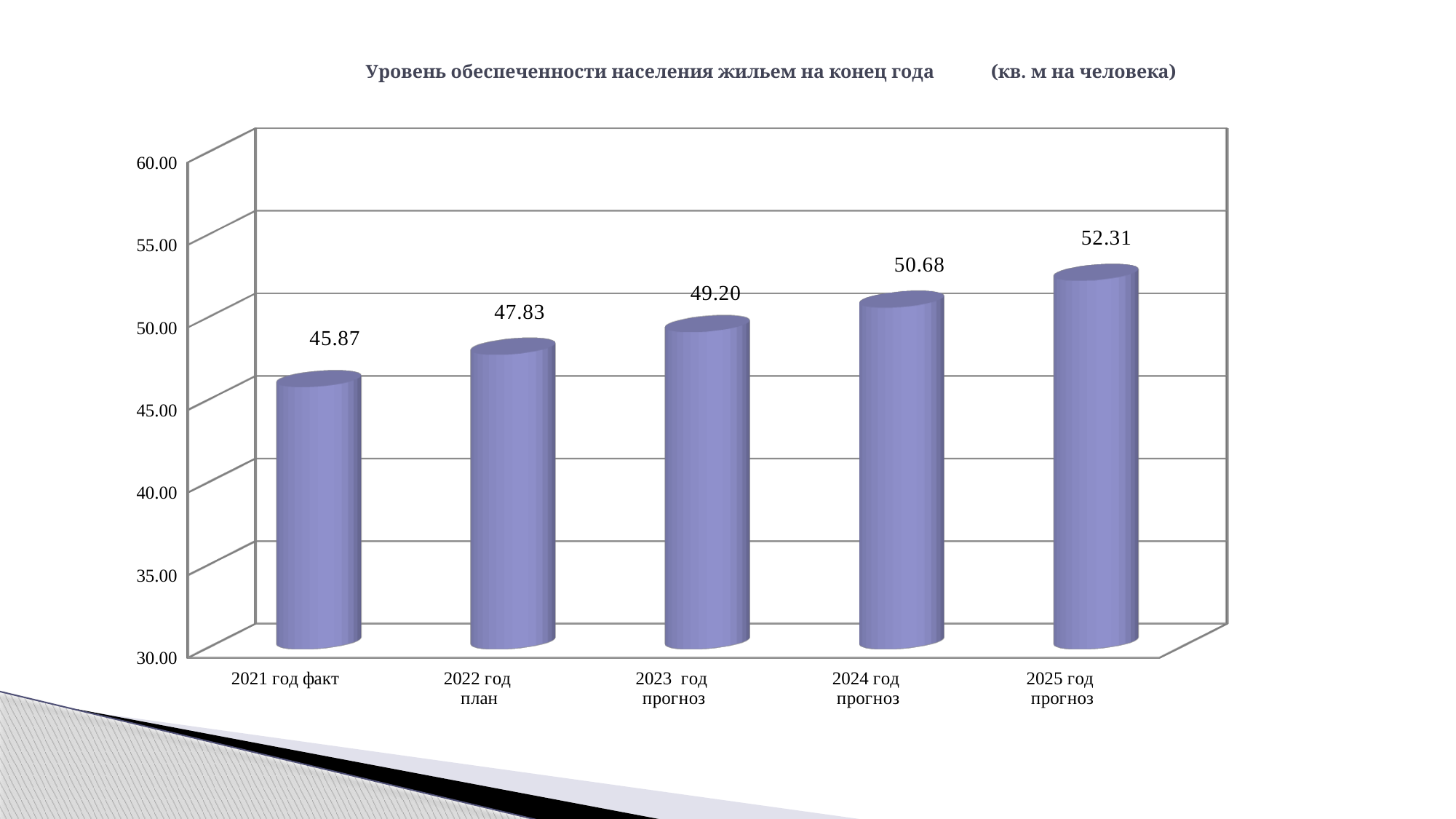
What is the difference between the values for 2024 год прогноз and 2022 год план? 2.85 Do the values rise or fall from 2021 to 2025 along the x axis? rise Which is larger, the value for 2022 год план or the value for 2024 год прогноз? 2024 год прогноз How many categories are shown on the x axis? 5 What is the value for 2021 год факт? 45.87 Is the value for 2023 год прогноз greater or less than 50.00? less What is the value for 2023 год прогноз? 49.20 What kind of chart is shown on the slide? bar chart What is the difference between the values for 2025 год прогноз and 2021 год факт? 6.44 Which category has the lowest value? 2021 год факт Which category has the highest value? 2025 год прогноз What is the value for 2025 год прогноз? 52.31